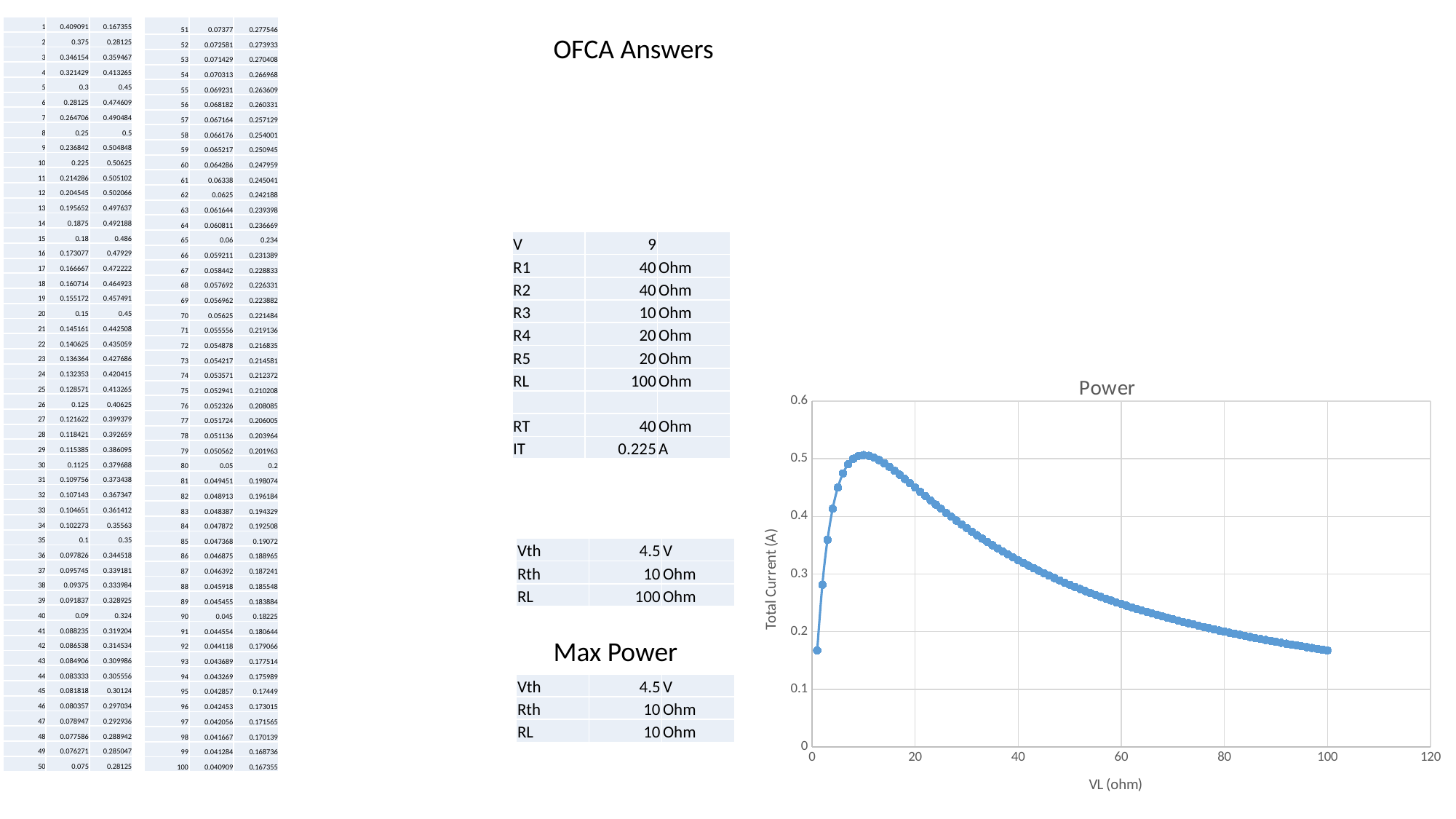
What kind of chart is the Power chart? line chart On the Power chart, do the values rise or fall as VL increases from 20 ohm to 100 ohm? fall What is the title of the chart on the right of the slide? Power On the Power chart, is the value for VL = 60 ohm greater or less than 0.3? less On the Power chart, is the value for VL = 20 ohm greater or less than 0.4? greater On the Power chart, is the value for VL = 100 ohm greater or less than 0.2? less On the Power chart, which has the larger total current: VL = 20 ohm or VL = 80 ohm? VL = 20 ohm On the Power chart, which has the larger total current: VL = 40 ohm or VL = 100 ohm? VL = 40 ohm What is the label of the x axis on the Power chart? VL (ohm)